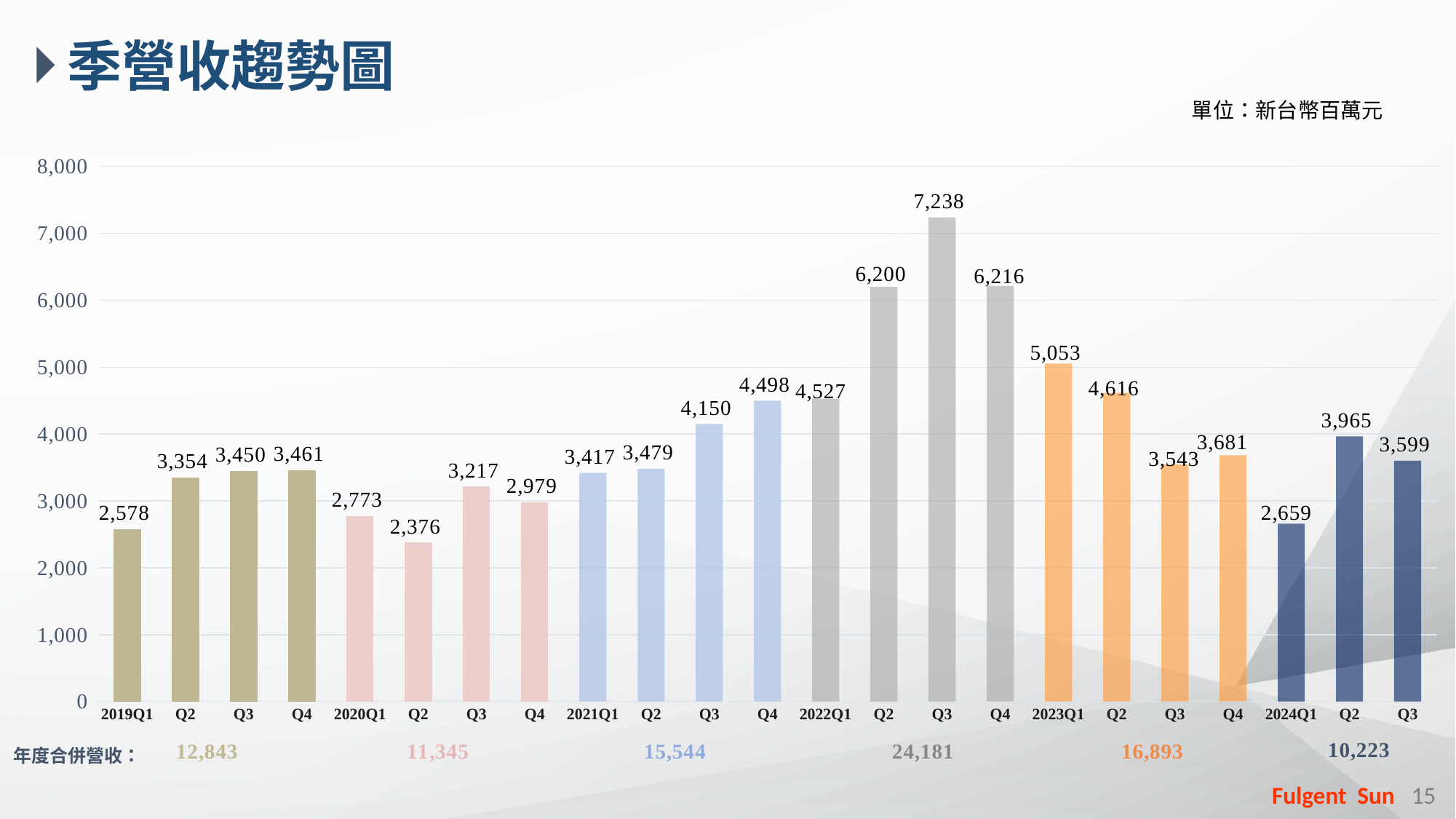
What is the revenue value for 2022 Q3? 7,238 What type of chart is shown on the slide? bar chart Do the quarterly revenue values rise or fall across the four quarters of 2019? rise What is the difference between the revenue for 2023 Q1 and 2023 Q2? 437 What is the difference between the revenue for 2022 Q3 and 2022 Q2? 1,038 What is the annual consolidated revenue (年度合併營收) shown for 2022? 24,181 Which quarter has the highest revenue? 2022 Q3 How many quarterly bars are plotted in the chart? 23 Which quarter has the lowest revenue? 2020 Q2 Which is larger, the revenue for 2023 Q1 or 2024 Q2? 2023 Q1 What is the revenue value for 2024 Q2? 3,965 What is the revenue value for 2020 Q2? 2,376